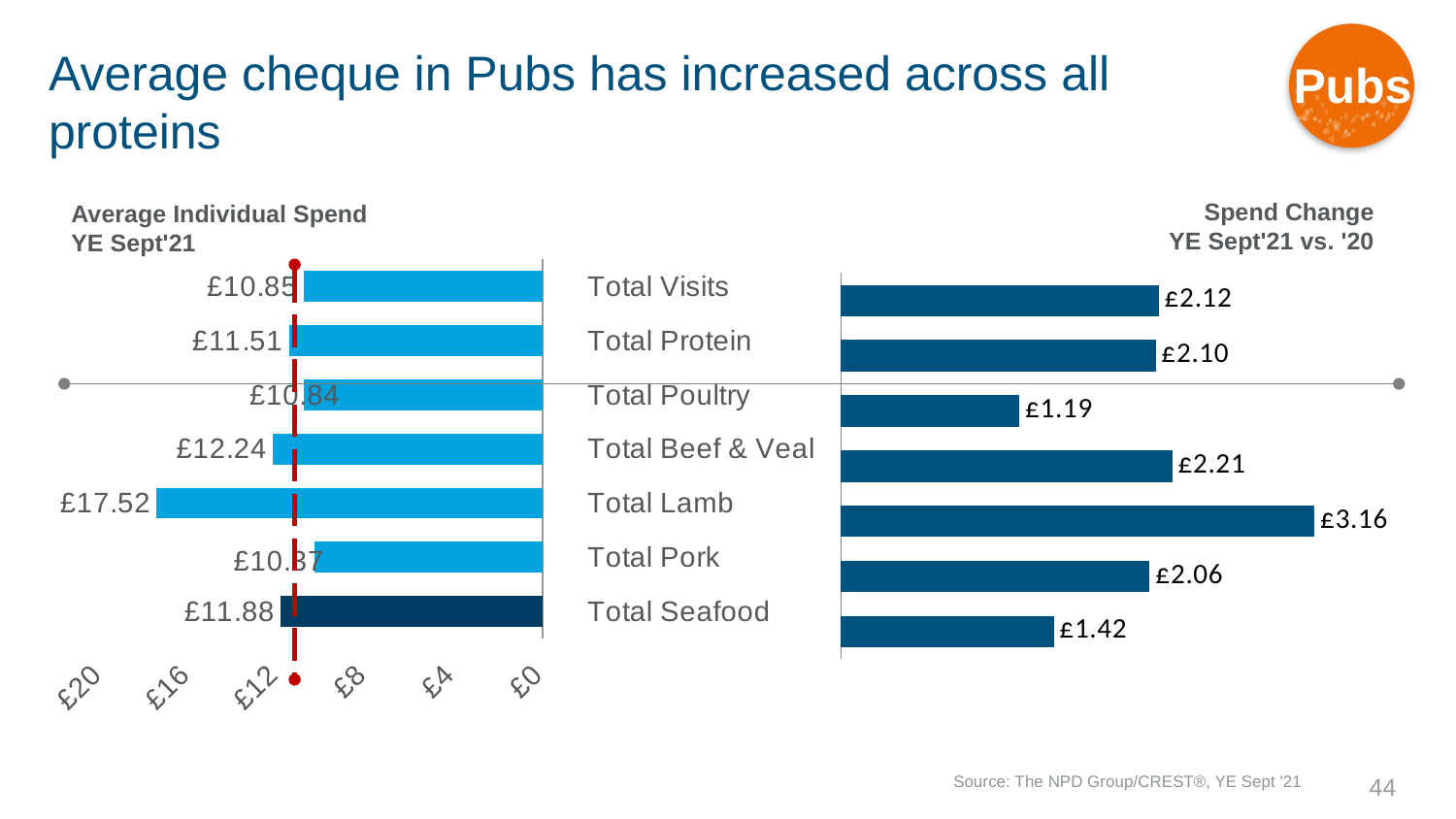
In the Spend Change YE Sept'21 vs. '20 chart, what is the difference between Total Lamb and Total Poultry? £1.97 In the Spend Change YE Sept'21 vs. '20 chart, which category has the lowest value? Total Poultry In the Average Individual Spend YE Sept'21 chart, is the value for Total Lamb greater or less than £16? greater How many categories are shown in the Spend Change YE Sept'21 vs. '20 chart? 7 In the Average Individual Spend YE Sept'21 chart, which is larger, Total Seafood or Total Protein? Total Seafood In the Average Individual Spend YE Sept'21 chart, what is the value for Total Beef & Veal? £12.24 In the Average Individual Spend YE Sept'21 chart, which category has the highest value? Total Lamb In the Spend Change YE Sept'21 vs. '20 chart, which category has the highest value? Total Lamb What kind of chart is the Average Individual Spend YE Sept'21 chart? Bar chart In the Spend Change YE Sept'21 vs. '20 chart, what is the value for Total Seafood? £1.42 In the Average Individual Spend YE Sept'21 chart, what is the value for Total Lamb? £17.52 In the Spend Change YE Sept'21 vs. '20 chart, what is the value for Total Poultry? £1.19